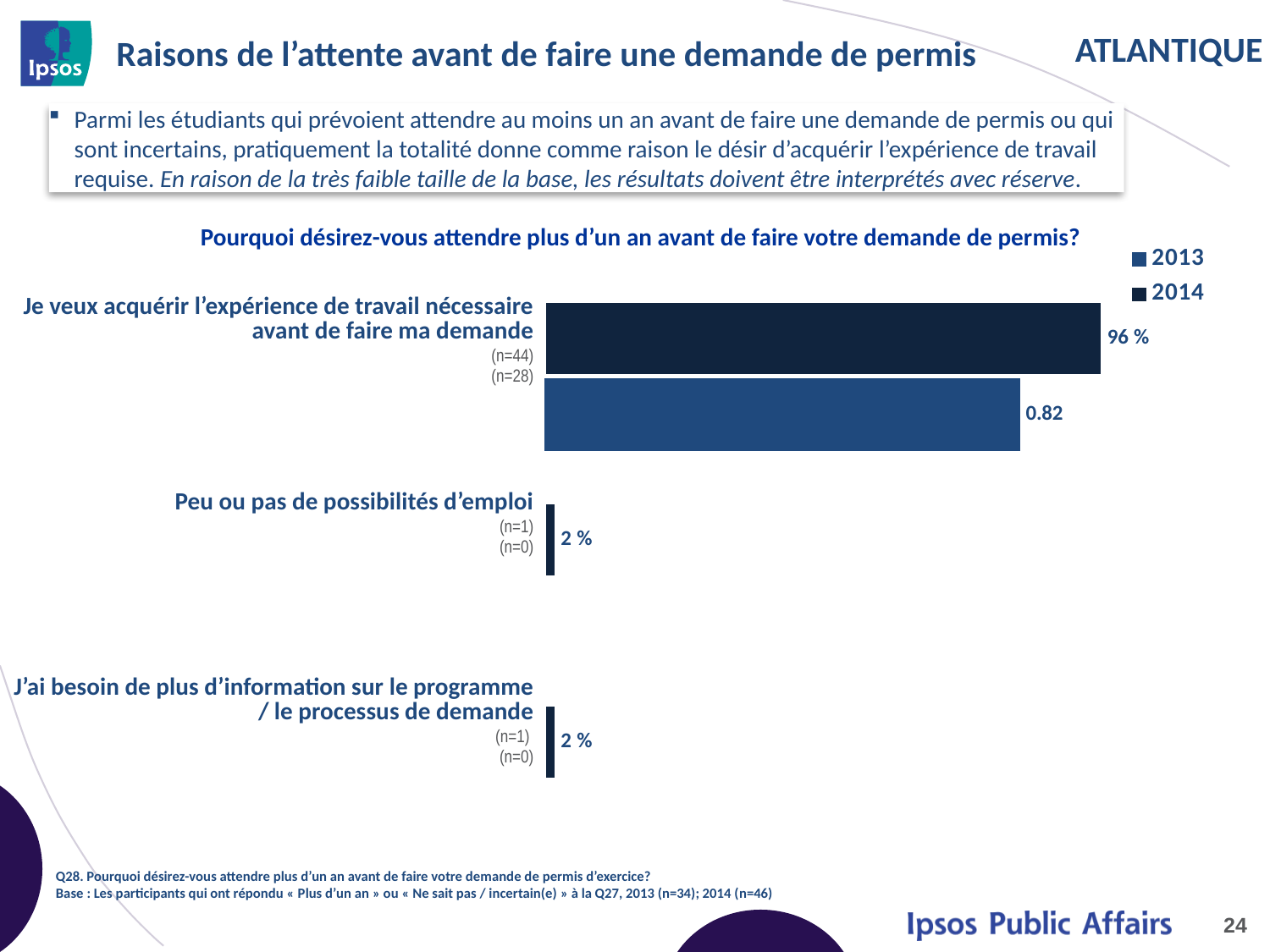
What is the 2013 value for "Peu ou pas de possibilités d'emploi"? 2 % How many categories are shown in the chart? 3 What is the title of the chart? Pourquoi désirez-vous attendre plus d'un an avant de faire votre demande de permis? What is the 2013 value for "Je veux acquérir l'expérience de travail nécessaire avant de faire ma demande"? 96 % How many series does the legend list? 2 What is the 2014 value for "Je veux acquérir l'expérience de travail nécessaire avant de faire ma demande"? 0.82 What kind of chart is shown on the slide? Bar chart What are the two entries in the chart legend? 2013 and 2014 For "Je veux acquérir l'expérience de travail nécessaire avant de faire ma demande", which year has the larger value, 2013 or 2014? 2013 What is the difference between the 2013 values for "Je veux acquérir l'expérience de travail nécessaire avant de faire ma demande" and "Peu ou pas de possibilités d'emploi"? 94 % What is the 2013 value for "J'ai besoin de plus d'information sur le programme / le processus de demande"? 2 % Which category has the highest 2013 value? Je veux acquérir l'expérience de travail nécessaire avant de faire ma demande